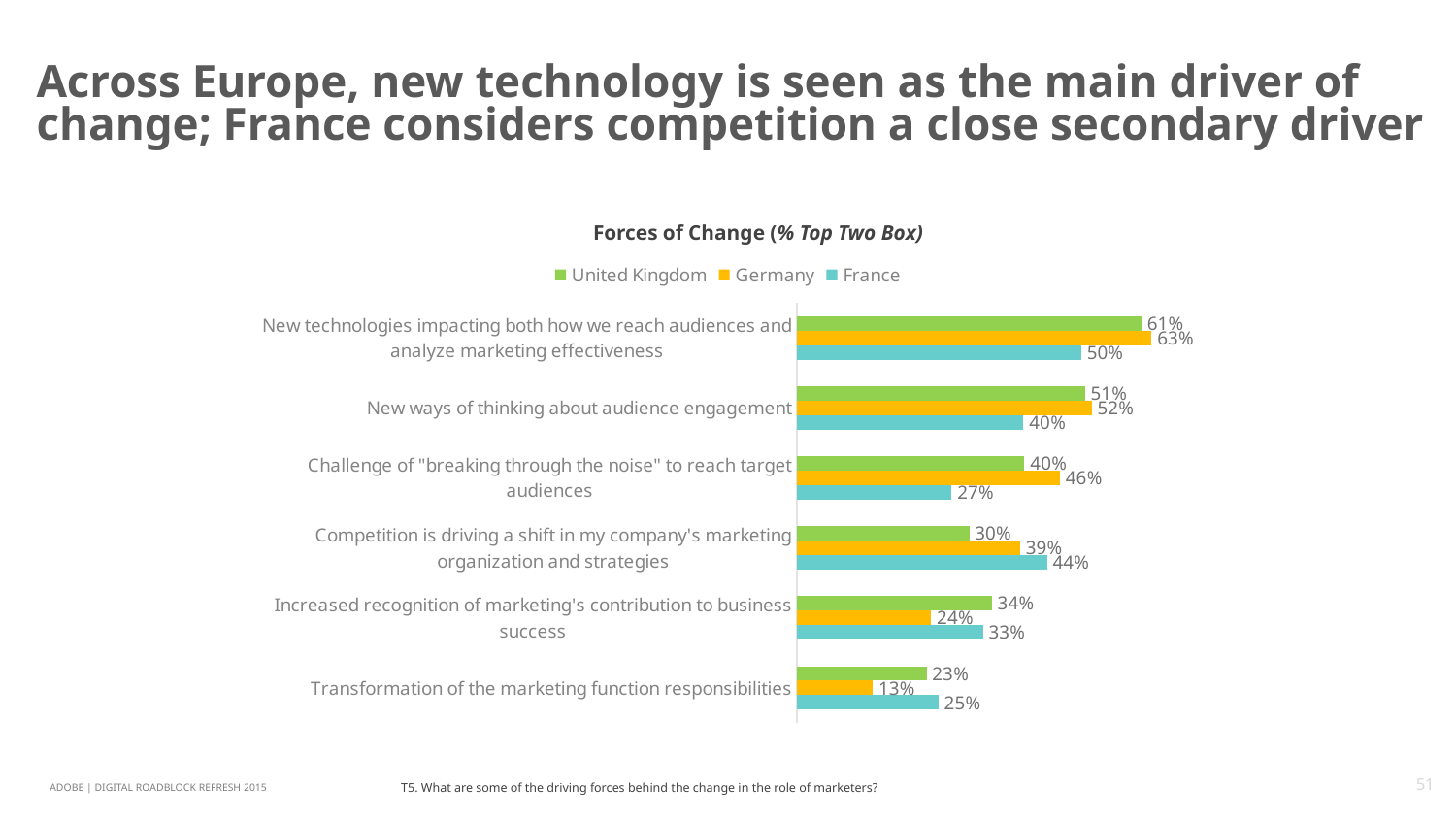
Which series is shown in yellow? Germany Which is larger for "Increased recognition of marketing's contribution to business success": the United Kingdom value or the Germany value? United Kingdom How many categories are shown on the chart? 6 What is the value for Germany on "New technologies impacting both how we reach audiences and analyze marketing effectiveness"? 63% How many series does the legend list? 3 What is the value for the United Kingdom on "Transformation of the marketing function responsibilities"? 23% What is the title of the chart? Forces of Change (% Top Two Box) What is the value for France on "Competition is driving a shift in my company's marketing organization and strategies"? 44% Which category has the highest value for France? New technologies impacting both how we reach audiences and analyze marketing effectiveness Which category has the lowest value for Germany? Transformation of the marketing function responsibilities What kind of chart is shown on the slide? Bar chart What is the difference between the Germany and France values for "Challenge of "breaking through the noise" to reach target audiences"? 19%